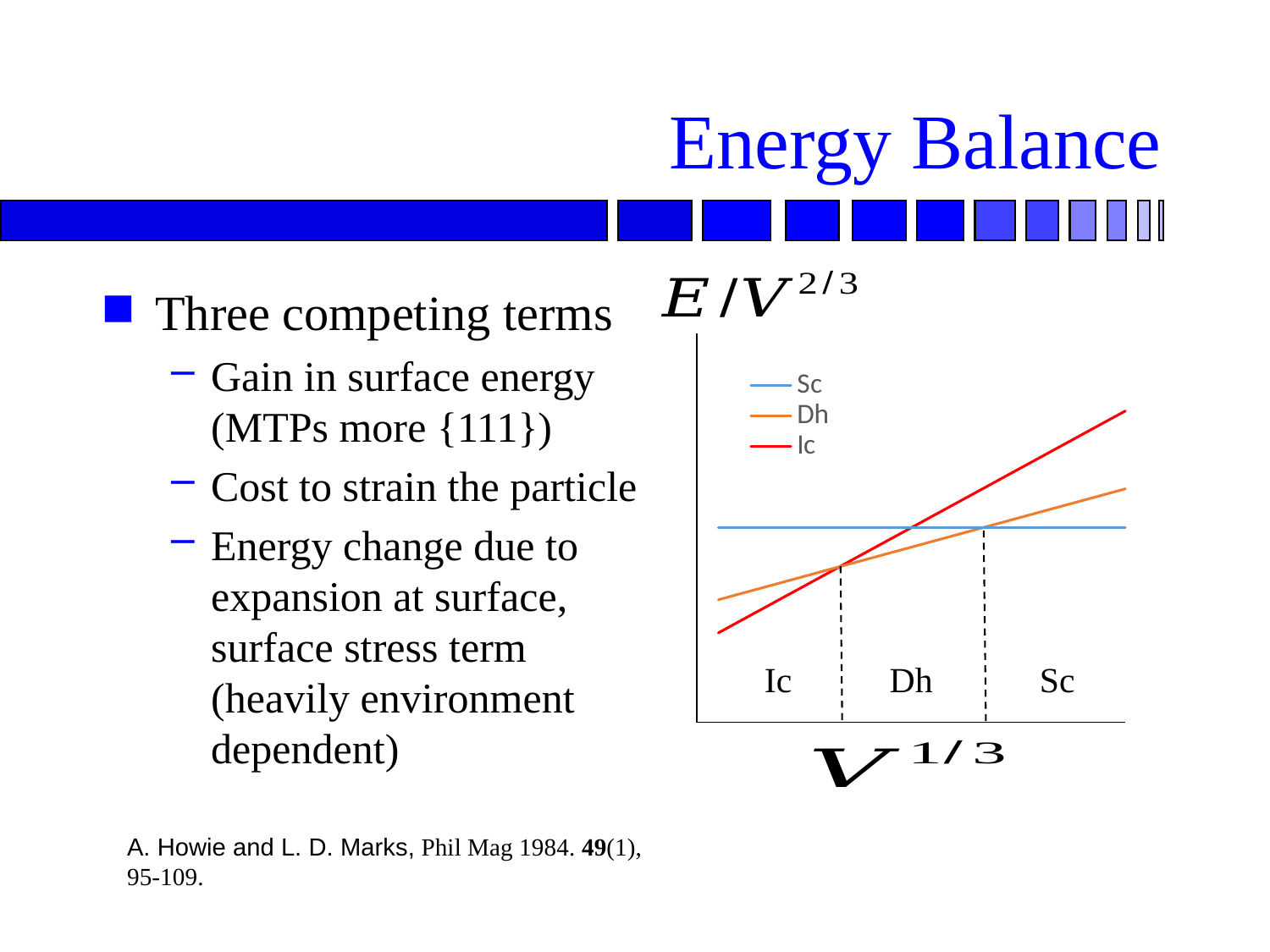
Does the Ic line rise or fall as V^(1/3) increases? rise Does the Sc line rise, fall, or stay flat as V^(1/3) increases? stay flat At the right end of the chart, which is larger, the Ic line or the Sc line? Ic Does the Dh line rise or fall as V^(1/3) increases? rise How many series does the chart's legend list? 3 At the left end of the chart, which is larger, the Sc line or the Dh line? Sc Which series are listed in the chart's legend? Sc, Dh, Ic How many regions are labelled along the x axis of the chart? 3 Which series has the highest value at the right end of the chart? Ic Which series has the lowest value at the left end of the chart? Ic What is the label on the chart's vertical axis? E/V^(2/3) What kind of chart is shown on the slide? line chart